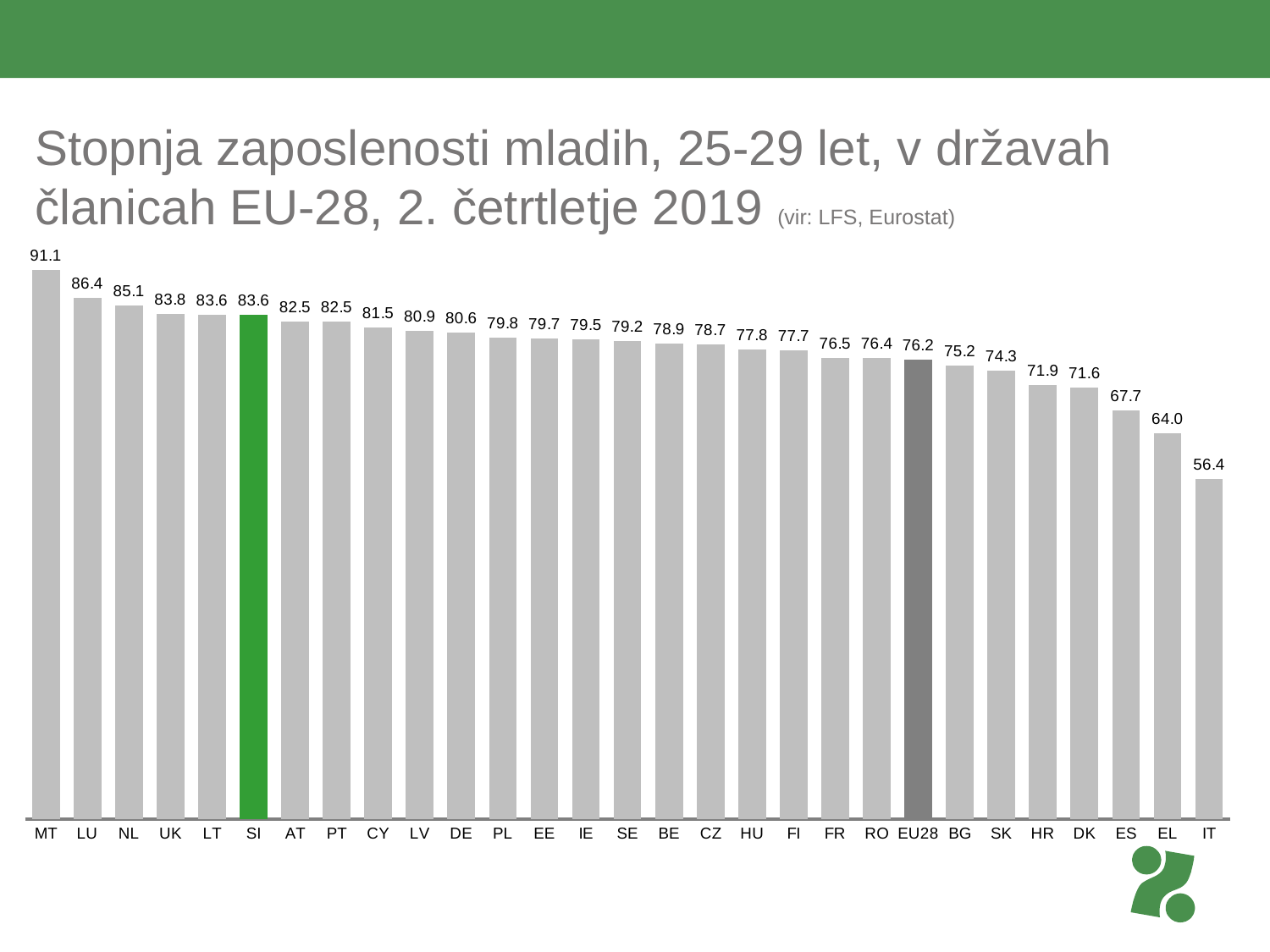
What kind of chart is shown on the slide? bar chart How many bars are shown in the chart? 29 What is the value for SI? 83.6 What is the value for DE? 80.6 Which is larger, the value for HR or the value for ES? HR What is the difference between the values for SI and EU28? 7.4 Which category has the lowest value? IT Which is larger, the value for LU or the value for NL? LU Which category has the highest value? MT What is the difference between the values for MT and IT? 34.7 Which bar is coloured green? SI What is the value for EU28? 76.2